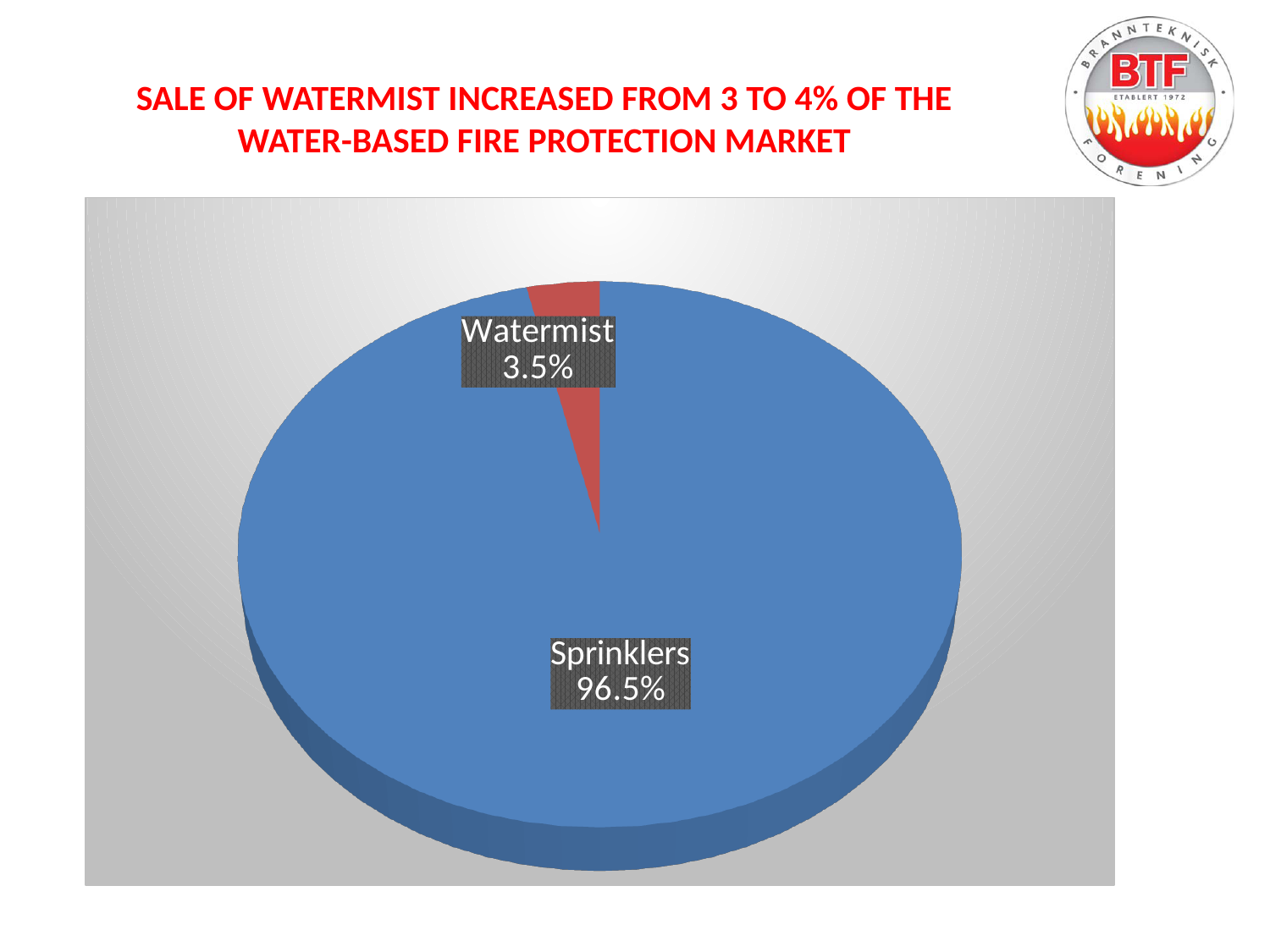
Which is larger, the Watermist slice or the Sprinklers slice? Sprinklers What share of the pie does Sprinklers have? 96.5% What colour is the Sprinklers slice? blue Which slice of the pie is the smallest? Watermist How many slices does the pie chart have? 2 What is the total of the two slice percentages shown on the pie chart? 100% Which slice of the pie is the largest? Sprinklers What share of the pie does Watermist have? 3.5% What kind of chart is shown on the slide? pie chart What is the difference in percentage points between the Sprinklers and Watermist slices? 93 percentage points What colour is the Watermist slice? red